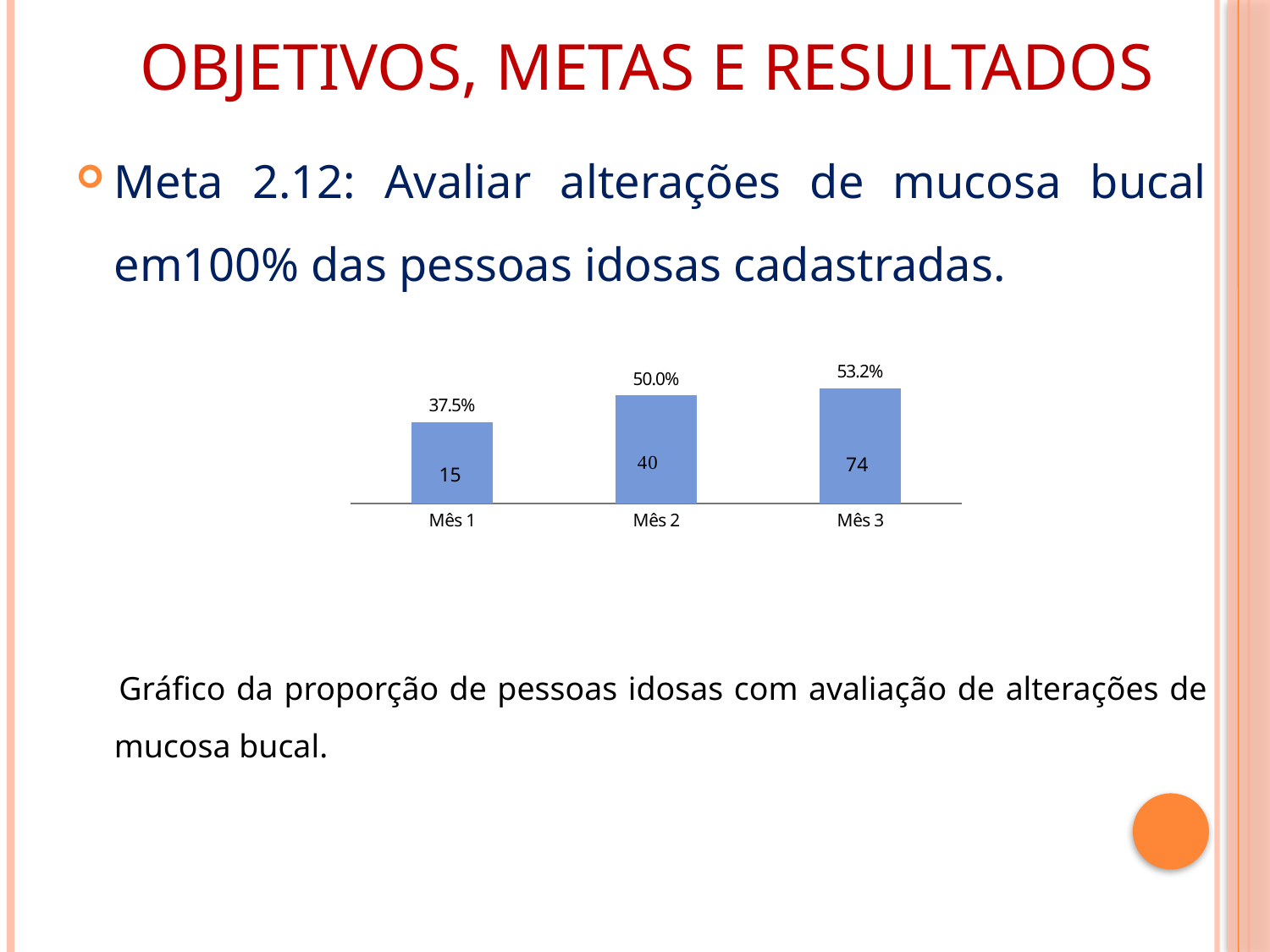
What number is printed inside the bar for Mês 1? 15 What is the difference between the percentages for Mês 2 and Mês 1? 12.5% What percentage is shown above the bar for Mês 1? 37.5% What kind of chart is shown on the slide? Bar chart What number is printed inside the bar for Mês 3? 74 What percentage is shown above the bar for Mês 3? 53.2% What is the difference between the numbers printed inside the bars for Mês 3 and Mês 2? 34 How many months (categories) are shown in the chart? 3 Which is larger, the percentage for Mês 1 or for Mês 2? Mês 2 Which month has the highest percentage? Mês 3 Which month has the lowest percentage? Mês 1 What percentage is shown above the bar for Mês 2? 50.0%